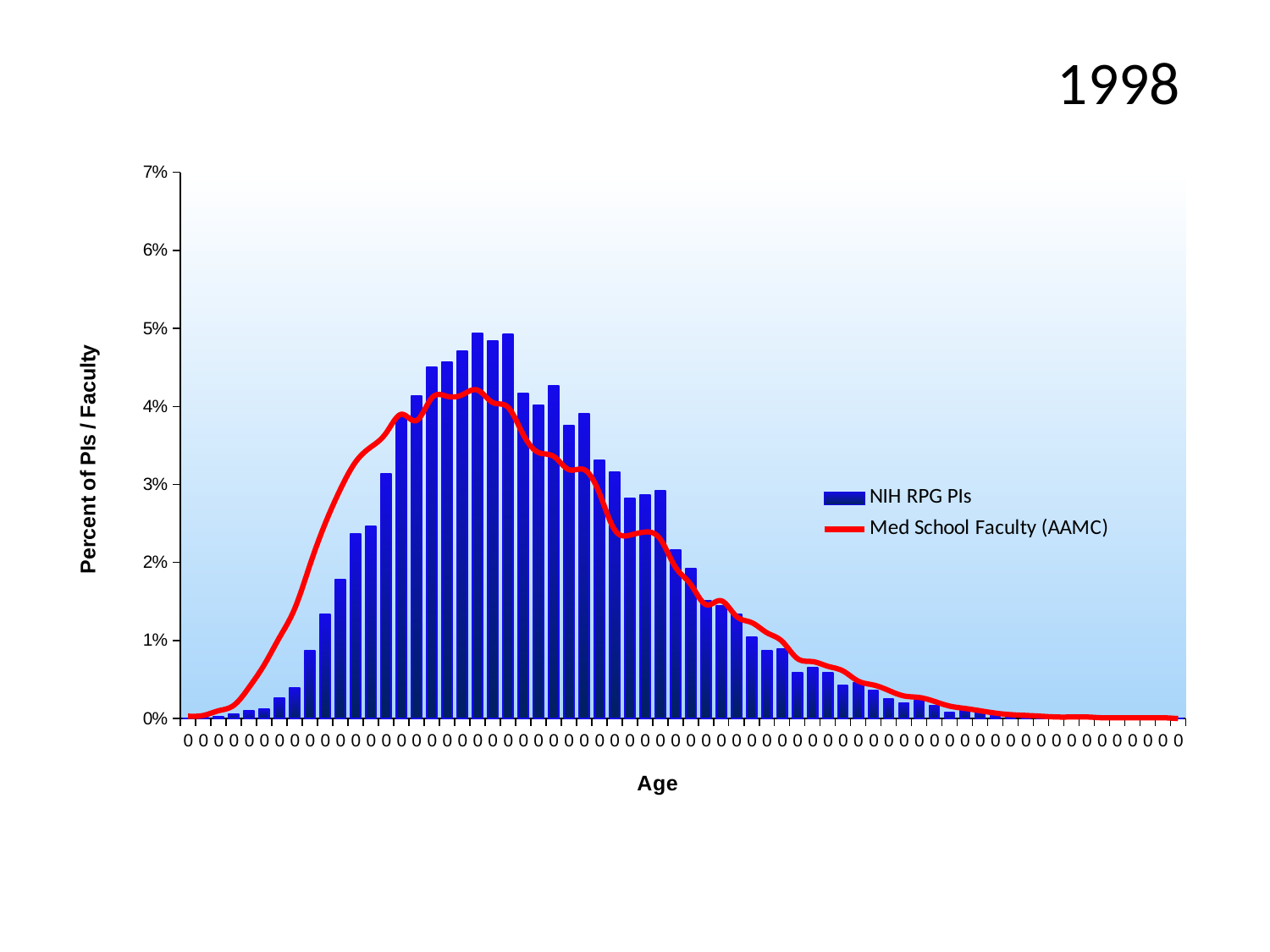
Which series is drawn as a red line? Med School Faculty (AAMC) Toward the right end of the x axis, do the NIH RPG PIs bars rise or fall? fall Which series reaches the higher peak value, NIH RPG PIs or Med School Faculty (AAMC)? NIH RPG PIs What is the title shown at the top of the slide? 1998 How many series does the legend list? 2 Is the peak of the Med School Faculty (AAMC) line greater or less than 5%? less What is the highest value shown on the y axis? 7% Is the peak of the Med School Faculty (AAMC) line greater or less than 3%? greater Are the values at the far right of the x axis greater or less than 1%? less What kind of chart is shown on the slide? bar chart with a line overlay